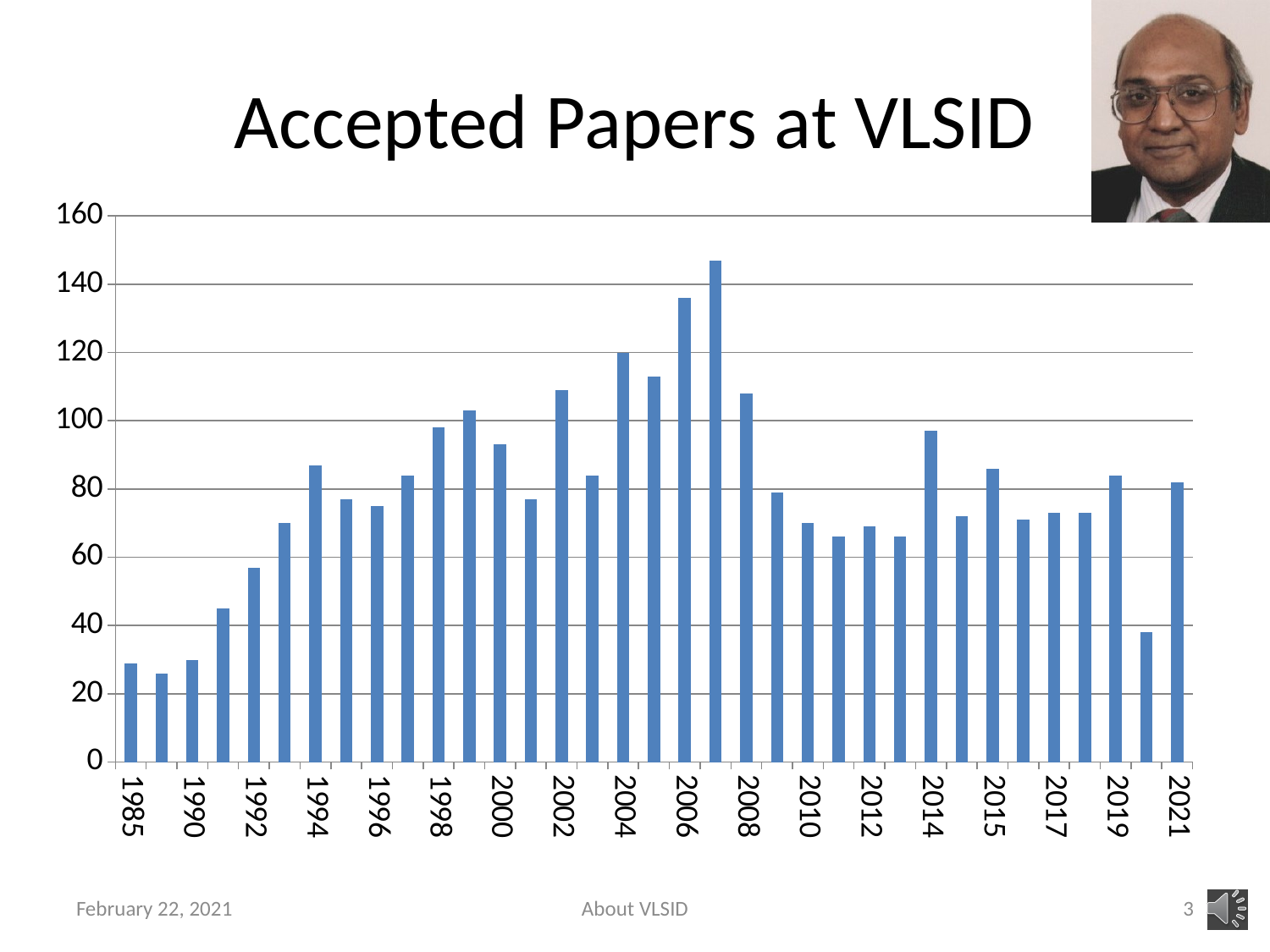
Is the value for 2010 greater or less than 80? less Which year has the larger value, 1985 or 2021? 2021 Which year has the larger value, 2006 or 2010? 2006 Is the value for 2014 greater or less than 80? greater Is the value for 1990 greater or less than 40? less What colour are the bars in the chart? blue What kind of chart is shown on the slide? bar chart What is the title of the chart? Accepted Papers at VLSID Do the values rise or fall from 1985 to 1994? rise